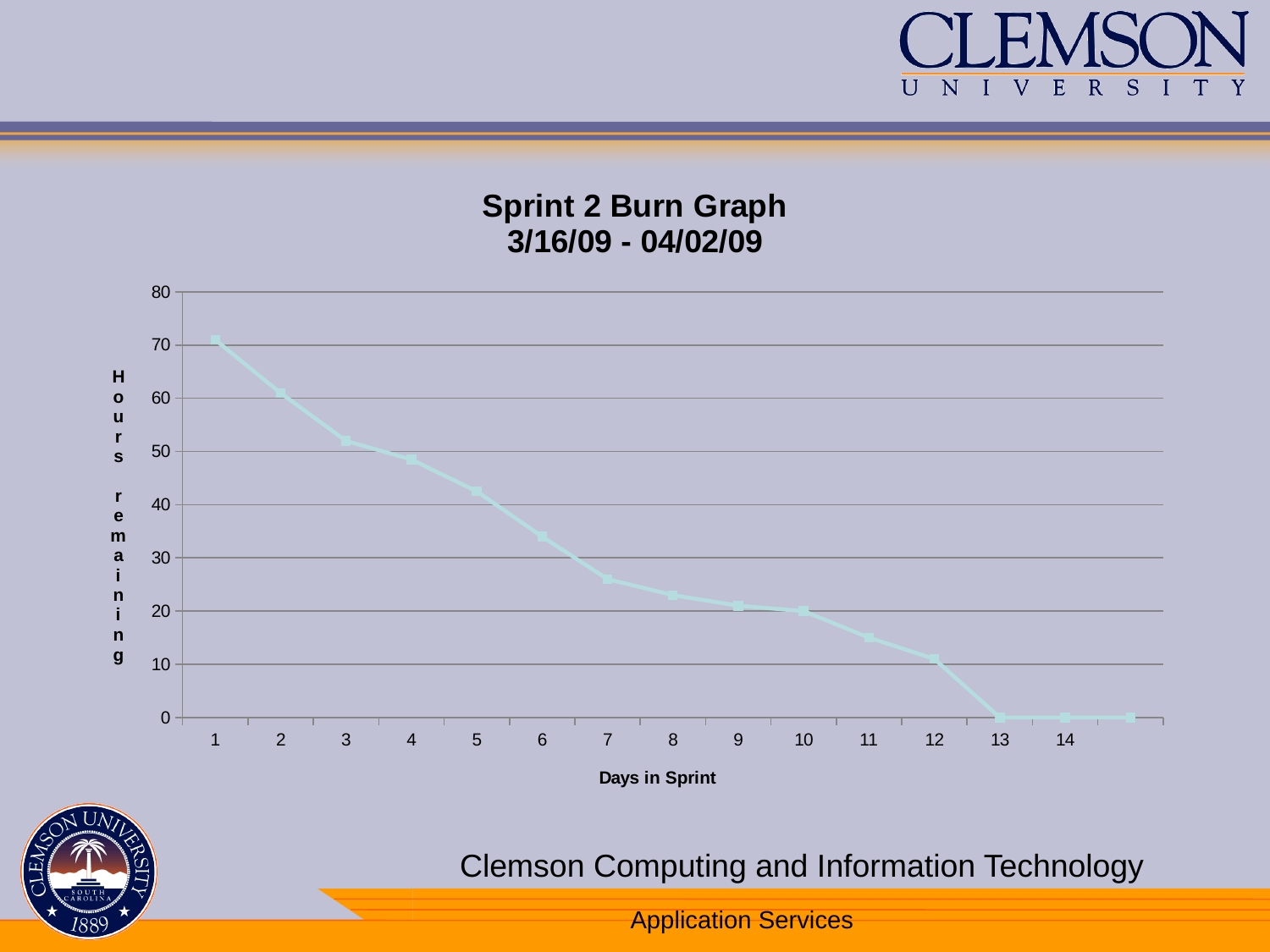
How many days are labeled on the x axis? 14 Is the value for day 3 greater or less than 50? greater What is the title of the chart? Sprint 2 Burn Graph 3/16/09 - 04/02/09 Which has more hours remaining, day 2 or day 7? day 2 On which day in the sprint are the hours remaining highest? 1 What kind of chart is shown on the slide? line chart Is the value for day 6 greater or less than 40? less What is the value of hours remaining on day 13? 0 What is the label of the x axis? Days in Sprint What is the value of hours remaining on day 14? 0 Do the hours remaining rise or fall as the days in the sprint increase? fall